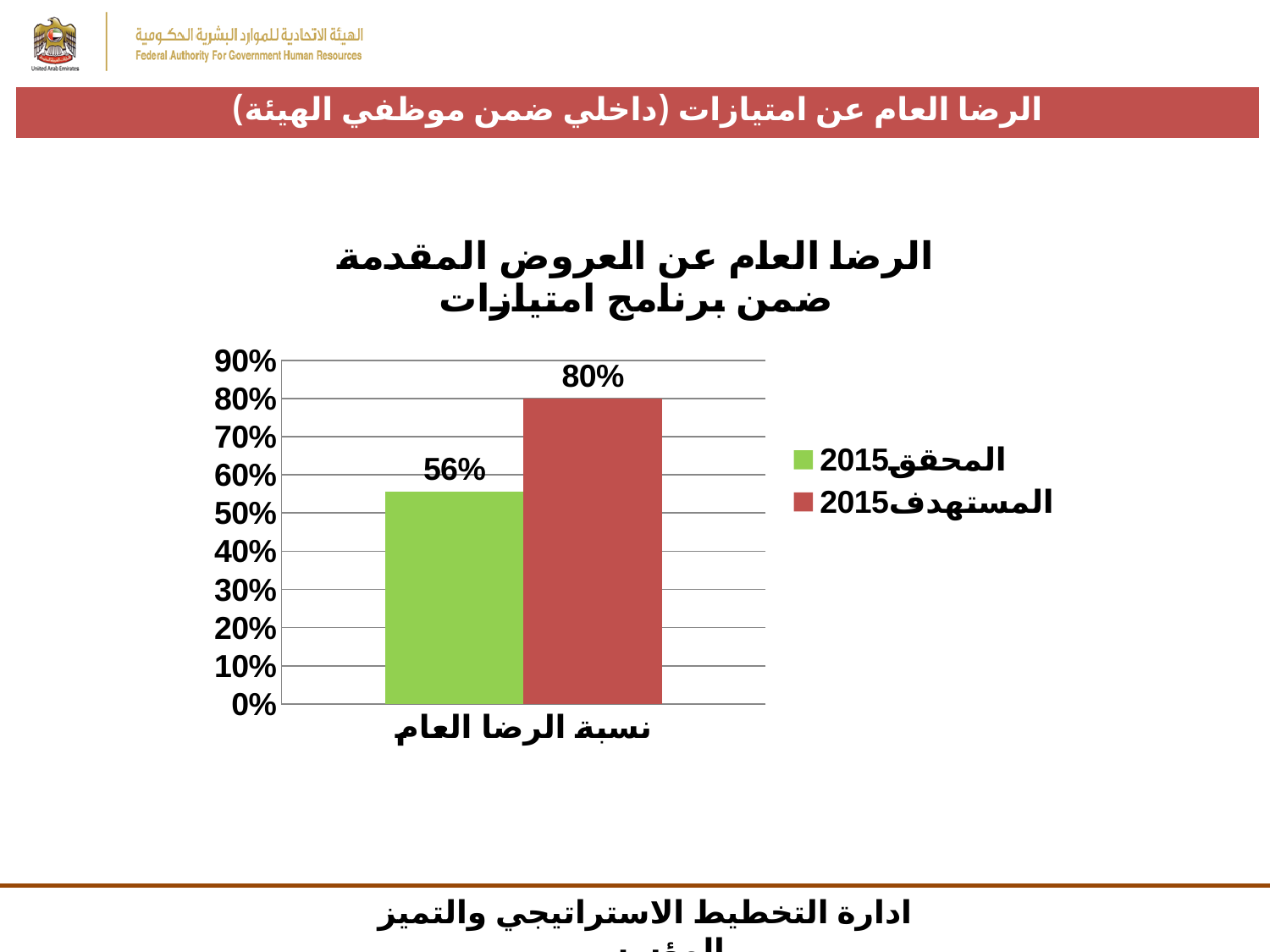
What is the value of the المستهدف 2015 series for نسبة الرضا العام? 80% What is the category label on the x axis? نسبة الرضا العام How many series does the legend list? 2 What is the highest value shown on the y axis? 90% What is the value of the المحقق 2015 series for نسبة الرضا العام? 56% Which series has the higher value, المحقق 2015 or المستهدف 2015? المستهدف 2015 Is the value for المحقق 2015 greater or less than 60%? less What is the difference between the المستهدف 2015 value and the المحقق 2015 value? 24% How many categories are shown on the x axis? 1 What kind of chart is shown on the slide? bar chart Is the value for المستهدف 2015 greater or less than 70%? greater Which series is shown in green? المحقق 2015